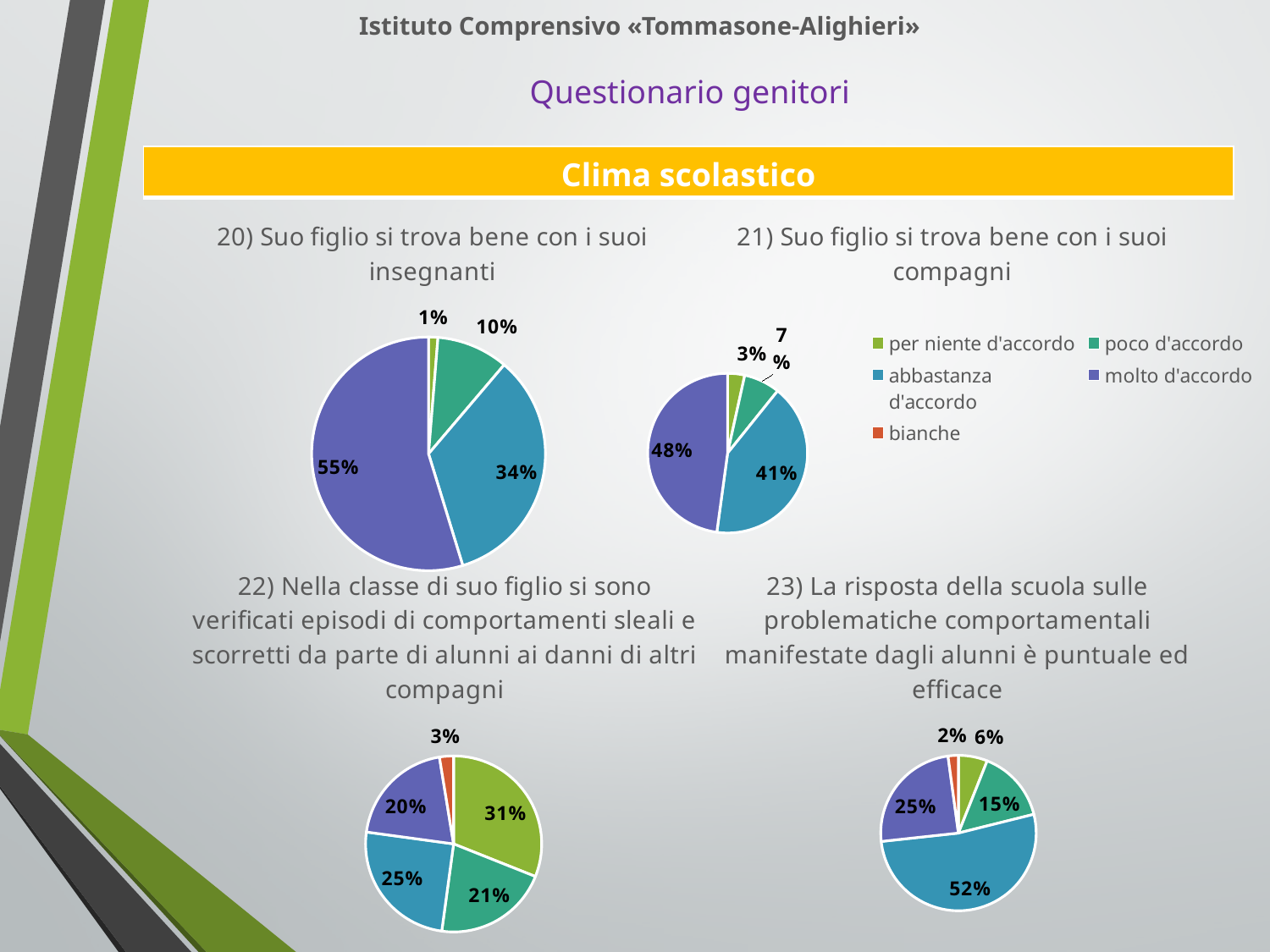
In the chart for question 20 (insegnanti), what percentage is shown for 'abbastanza d'accordo'? 34% In the chart for question 20 (insegnanti), which is larger: 'poco d'accordo' or 'abbastanza d'accordo'? abbastanza d'accordo How many categories does the shared legend list? 5 In the chart for question 23, what is the difference between the 'molto d'accordo' and 'poco d'accordo' percentages? 10% In the chart for question 21 (compagni), which category has the largest slice? molto d'accordo In the chart for question 22 (comportamenti sleali e scorretti), which category has the smallest slice? bianche In the chart for question 22 (comportamenti sleali e scorretti), what percentage is shown for 'per niente d'accordo'? 31% In the chart for question 20 (Suo figlio si trova bene con i suoi insegnanti), what percentage is shown for 'molto d'accordo'? 55% In the chart for question 21 (compagni), what is the combined share of 'abbastanza d'accordo' and 'molto d'accordo'? 89% What type of chart is used for question 22? pie chart In the chart for question 21 (Suo figlio si trova bene con i suoi compagni), what percentage is shown for 'abbastanza d'accordo'? 41% In the chart for question 23 (La risposta della scuola sulle problematiche comportamentali), what percentage is shown for 'abbastanza d'accordo'? 52%